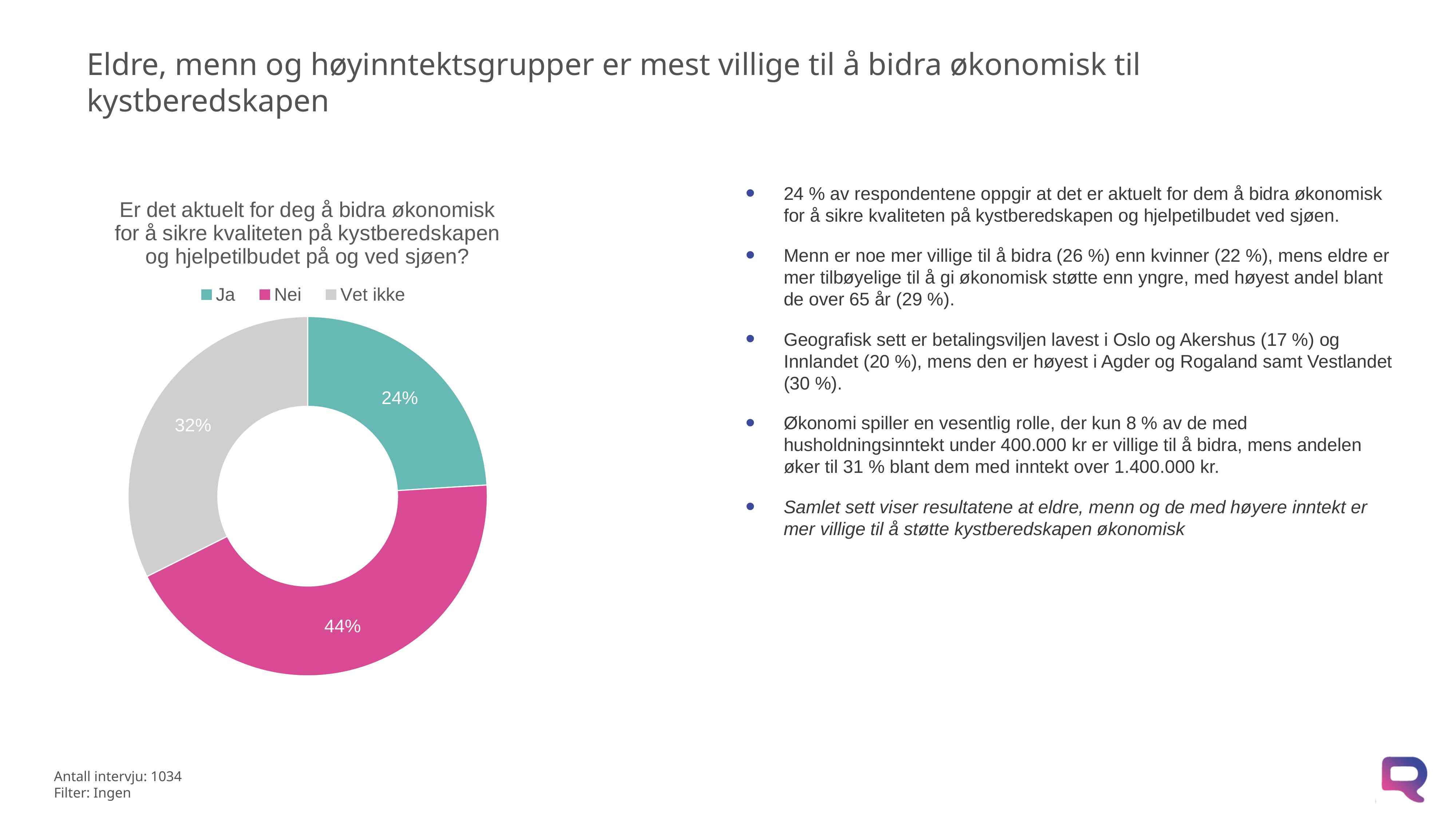
How many interviews (Antall intervju) does the slide report? 1034 Which response category has the smallest share of the chart? Ja What is the difference in percentage points between "Nei" and "Ja"? 20 What is the difference in percentage points between "Vet ikke" and "Ja"? 8 What percentage of respondents answered "Nei"? 44% Which response category has the largest share of the chart? Nei What colour represents "Nei" in the chart? Pink/magenta What percentage of respondents answered "Ja"? 24% What percentage of respondents answered "Vet ikke"? 32% What kind of chart is shown on the slide? Doughnut (pie) chart How many categories does the chart show? 3 Which is larger, the share for "Vet ikke" or the share for "Ja"? Vet ikke